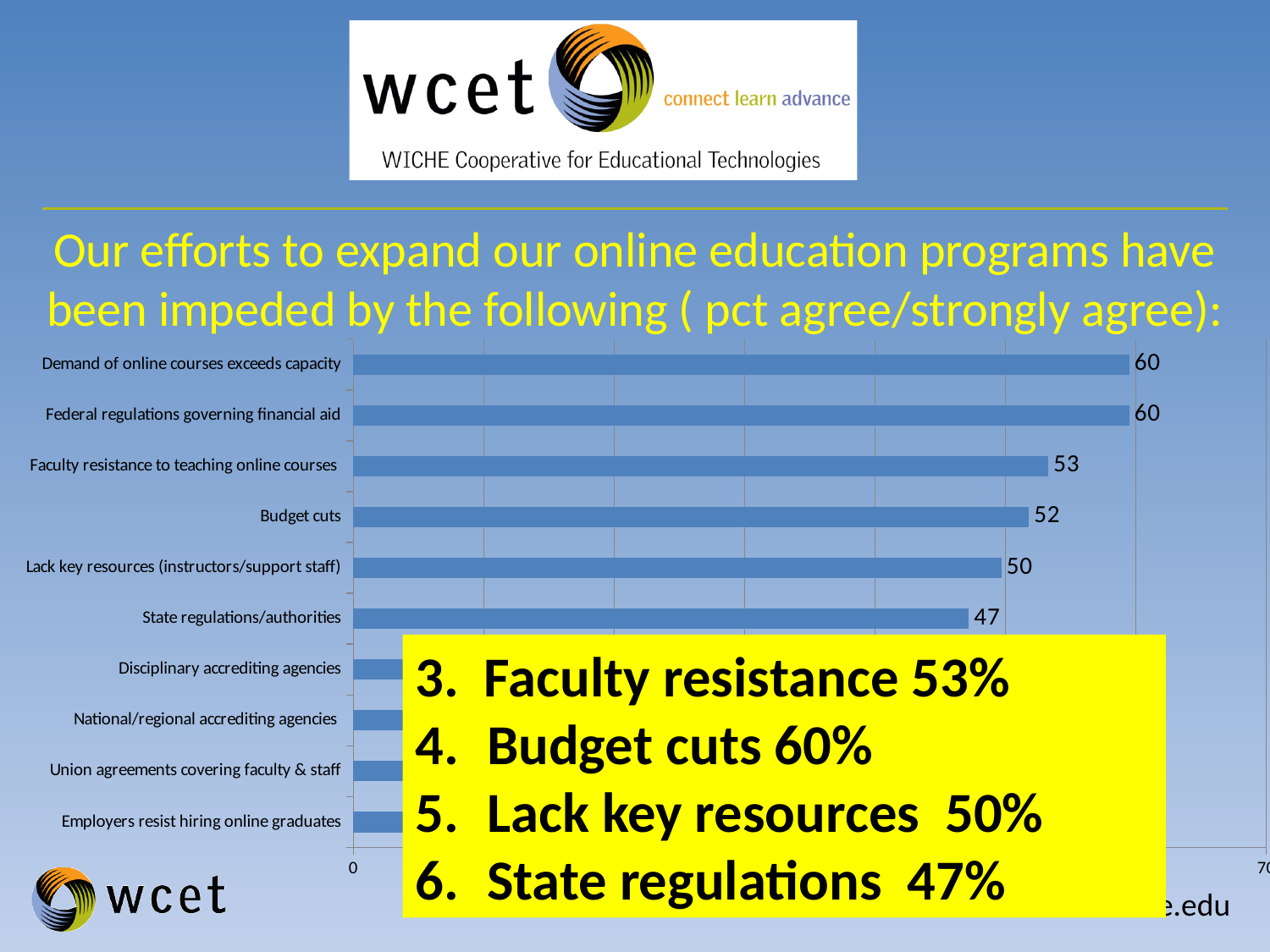
How many categories are listed on the chart? 10 What is the value for "State regulations/authorities"? 47 Do the bar values rise or fall going from the top of the chart to the bottom? Fall What value does the chart show for "Budget cuts"? 52 Which has a larger value, "Budget cuts" or "Lack key resources (instructors/support staff)"? Budget cuts What is the value for "Demand of online courses exceeds capacity"? 60 What is the difference between the values for "Faculty resistance to teaching online courses" and "State regulations/authorities"? 6 What type of chart is shown on the slide? Bar chart What is the value for "Lack key resources (instructors/support staff)"? 50 What value is shown for "Faculty resistance to teaching online courses"? 53 What is the difference between the values for "Demand of online courses exceeds capacity" and "Budget cuts"? 8 What is the value for "Federal regulations governing financial aid"? 60